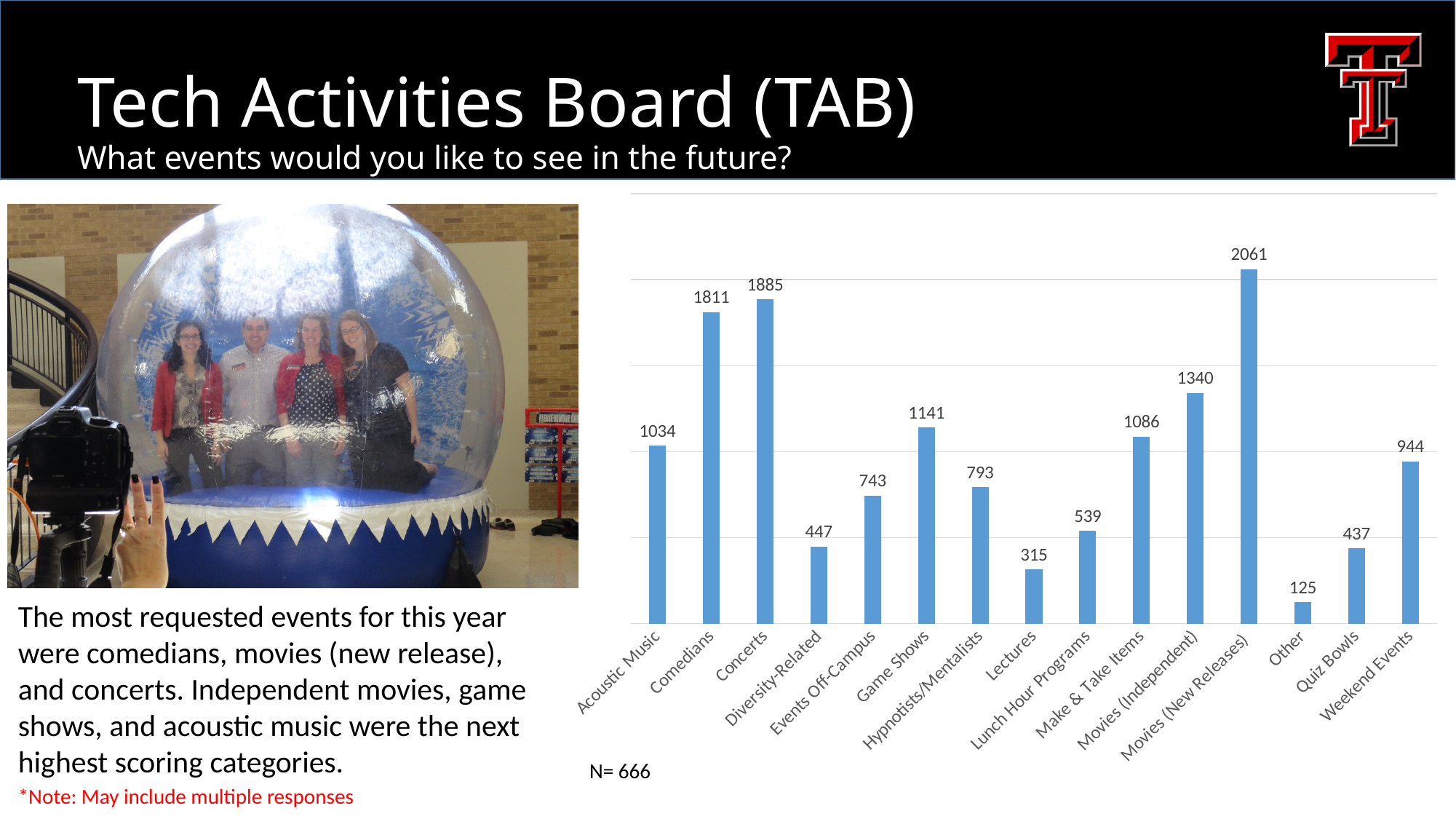
What is the value for Game Shows? 1141 What is the value for Movies (New Releases)? 2061 What kind of chart is shown on the slide? Bar chart How many categories are shown on the x axis? 15 What is the difference between the values for Movies (New Releases) and Movies (Independent)? 721 Which is larger, the value for Weekend Events or the value for Hypnotists/Mentalists? Weekend Events Which is larger, the value for Lectures or the value for Diversity-Related? Diversity-Related Which category has the highest value? Movies (New Releases) What is the difference between the values for Concerts and Comedians? 74 What is the value for Quiz Bowls? 437 What is the value for Lunch Hour Programs? 539 Which category has the lowest value? Other